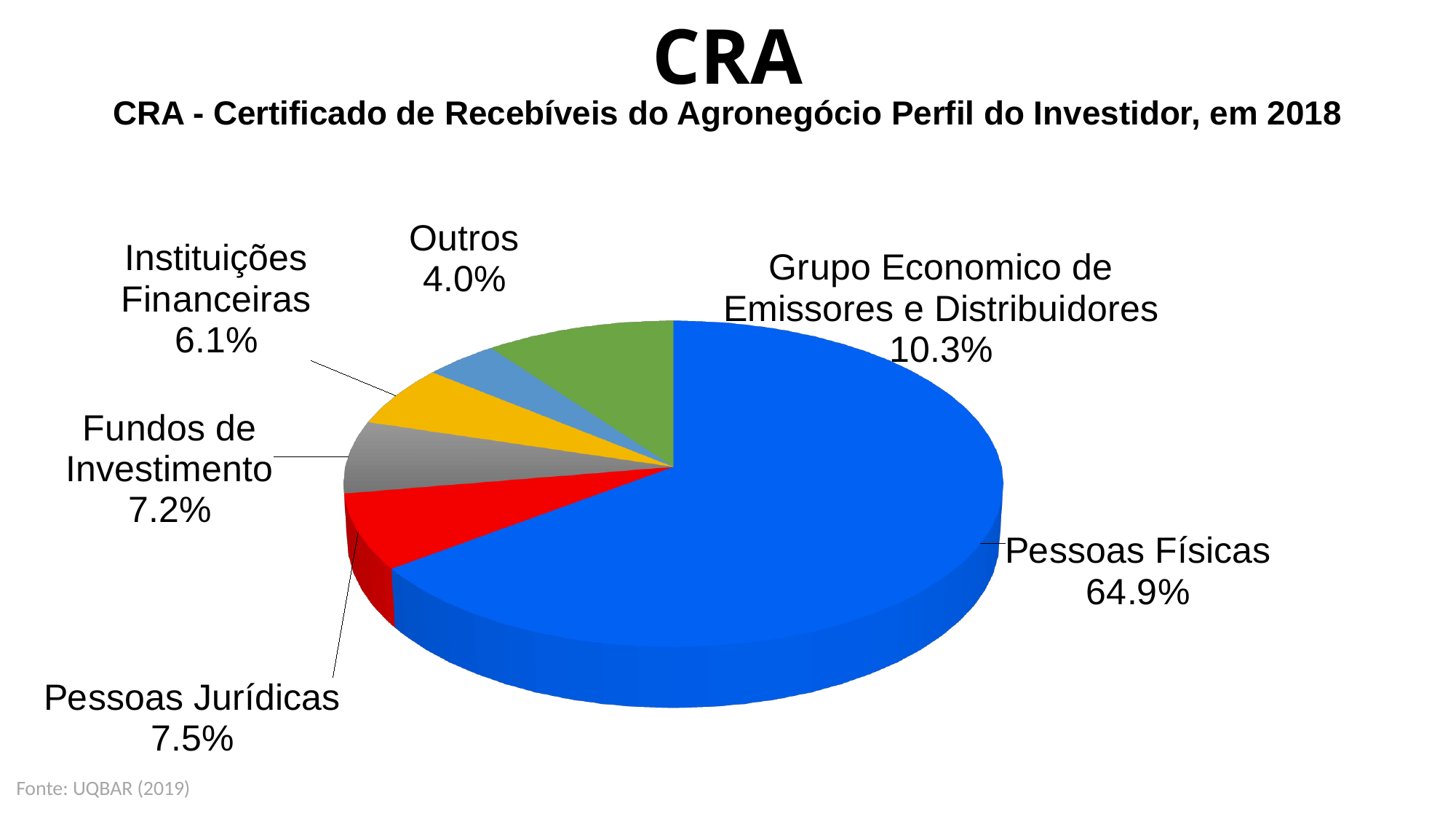
What is the value for Fundos de Investimento? 7.2% Which category has the largest slice of the pie? Pessoas Físicas What kind of chart is shown on the slide? Pie chart What share of the pie does Pessoas Físicas hold? 64.9% What is the value for Instituições Financeiras? 6.1% What is the difference between the shares of Pessoas Físicas and Grupo Economico de Emissores e Distribuidores? 54.6% What colour is the Pessoas Físicas slice? Blue Which is larger, the share of Pessoas Jurídicas or the share of Instituições Financeiras? Pessoas Jurídicas Which category has the smallest slice of the pie? Outros What is the value for Grupo Economico de Emissores e Distribuidores? 10.3% What is the difference between the shares of Pessoas Jurídicas and Fundos de Investimento? 0.3% How many categories are shown in the pie chart? 6